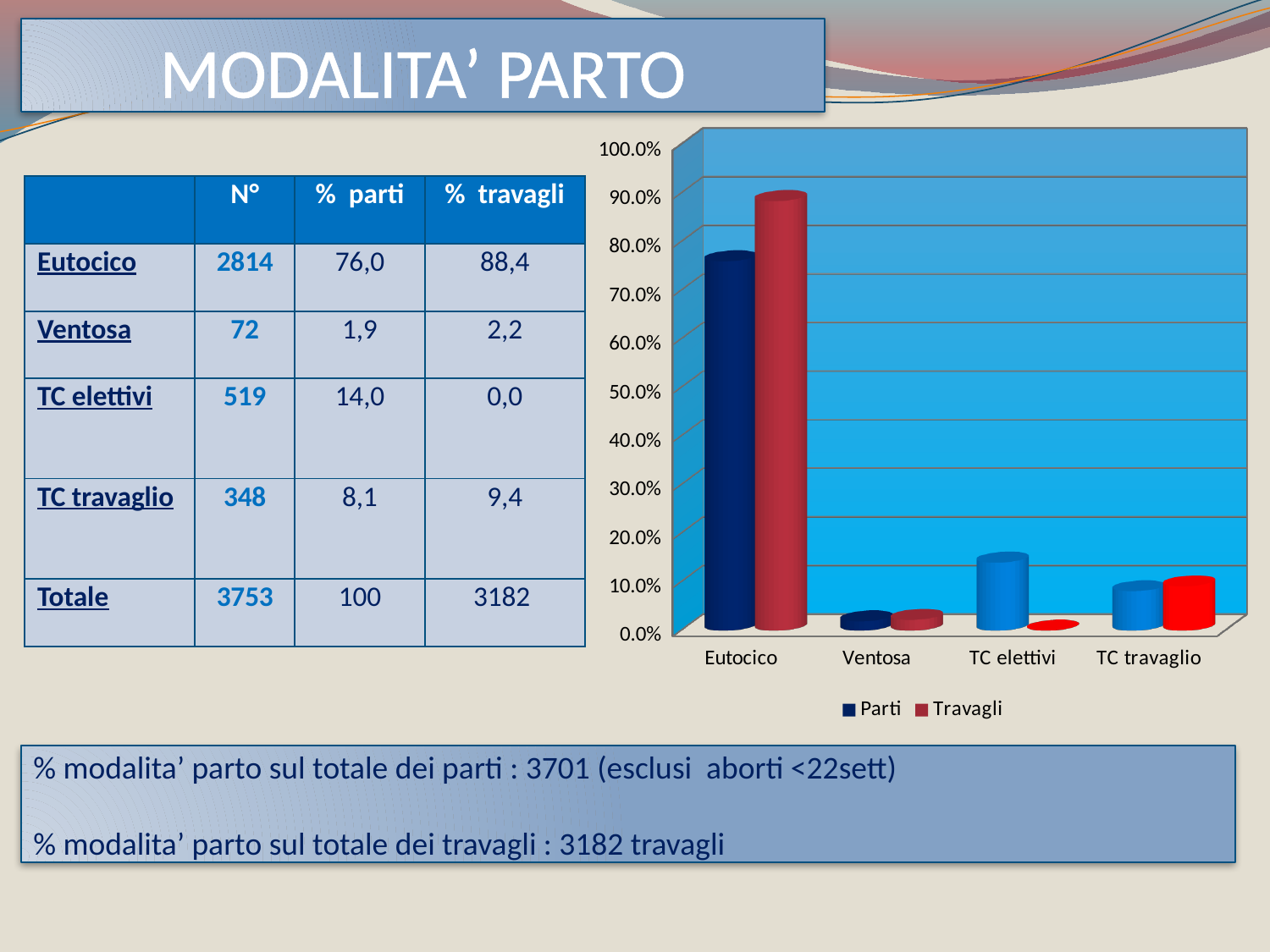
Which category has the highest value for the Parti series? Eutocico Which category has the lowest value for the Parti series? Ventosa Is the Travagli value for Eutocico greater or less than 80.0%? greater Is the Parti value for Ventosa greater or less than 10.0%? less What kind of chart is shown on the slide? bar chart What are the two series names listed in the chart legend? Parti and Travagli How many categories are shown on the x axis of the chart? 4 For Eutocico, which series has the larger value, Parti or Travagli? Travagli Is the Parti value for Eutocico greater or less than 70.0%? greater How many series does the chart legend list? 2 For TC elettivi, which series has the larger value, Parti or Travagli? Parti Which category has the lowest value for the Travagli series? TC elettivi